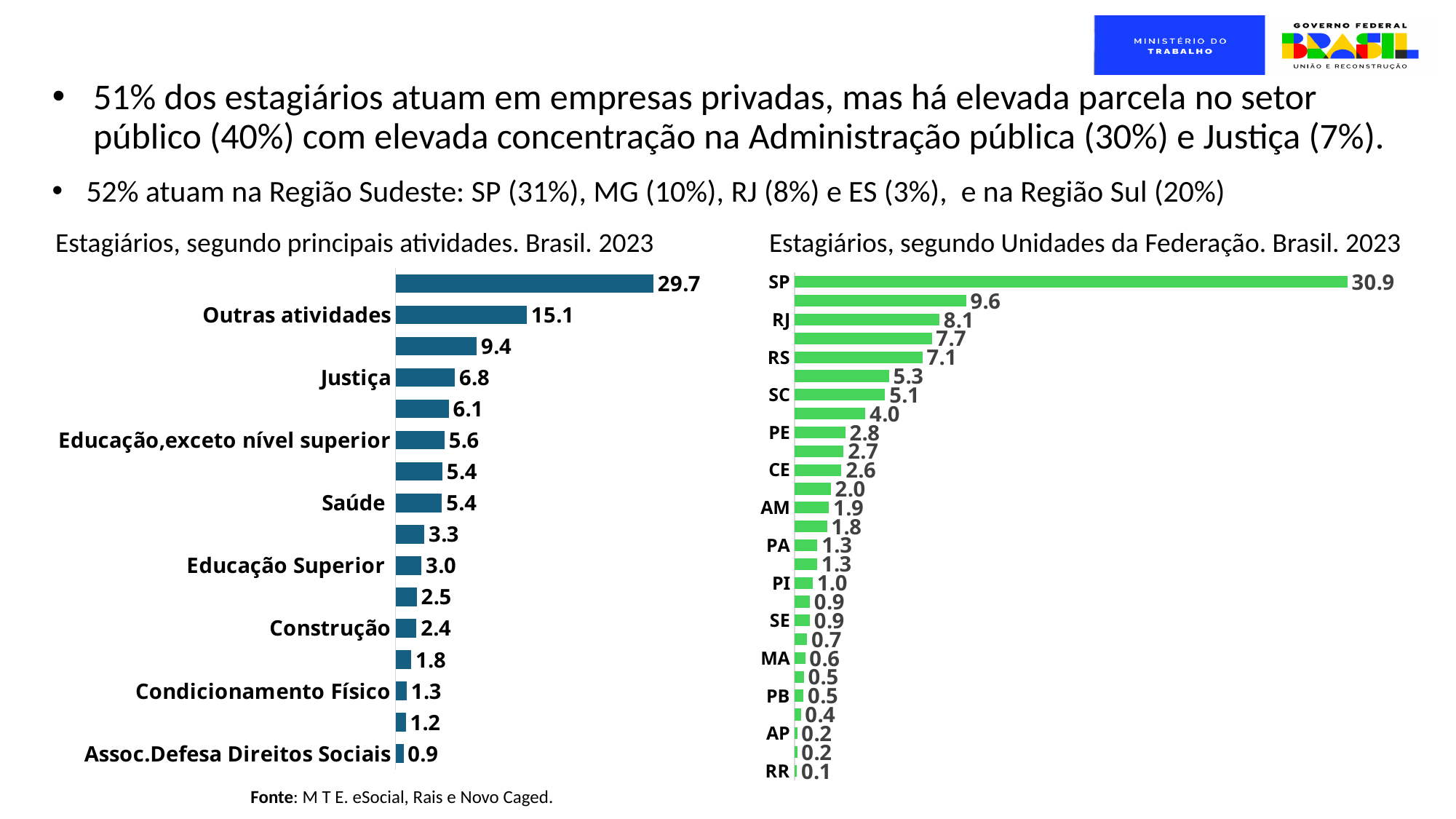
In the chart 'Estagiários, segundo principais atividades. Brasil. 2023', what is the value for Justiça? 6.8 What kind of chart is 'Estagiários, segundo principais atividades. Brasil. 2023'? Bar chart In the chart 'Estagiários, segundo principais atividades. Brasil. 2023', what is the difference between the values for Outras atividades and Saúde? 9.7 In the chart 'Estagiários, segundo Unidades da Federação. Brasil. 2023', which state has the lowest value? RR In the chart 'Estagiários, segundo Unidades da Federação. Brasil. 2023', what is the difference between the values for SP and RJ? 22.8 In the chart 'Estagiários, segundo Unidades da Federação. Brasil. 2023', which is larger, the value for SC or the value for PE? SC In the chart 'Estagiários, segundo principais atividades. Brasil. 2023', what is the value for Outras atividades? 15.1 In the chart 'Estagiários, segundo Unidades da Federação. Brasil. 2023', how many bars are plotted? 27 In the chart 'Estagiários, segundo Unidades da Federação. Brasil. 2023', what is the value for RS? 7.1 In the chart 'Estagiários, segundo Unidades da Federação. Brasil. 2023', which state has the highest value? SP In the chart 'Estagiários, segundo Unidades da Federação. Brasil. 2023', what is the value for SP? 30.9 In the chart 'Estagiários, segundo principais atividades. Brasil. 2023', which labelled activity has the lowest value? Assoc.Defesa Direitos Sociais